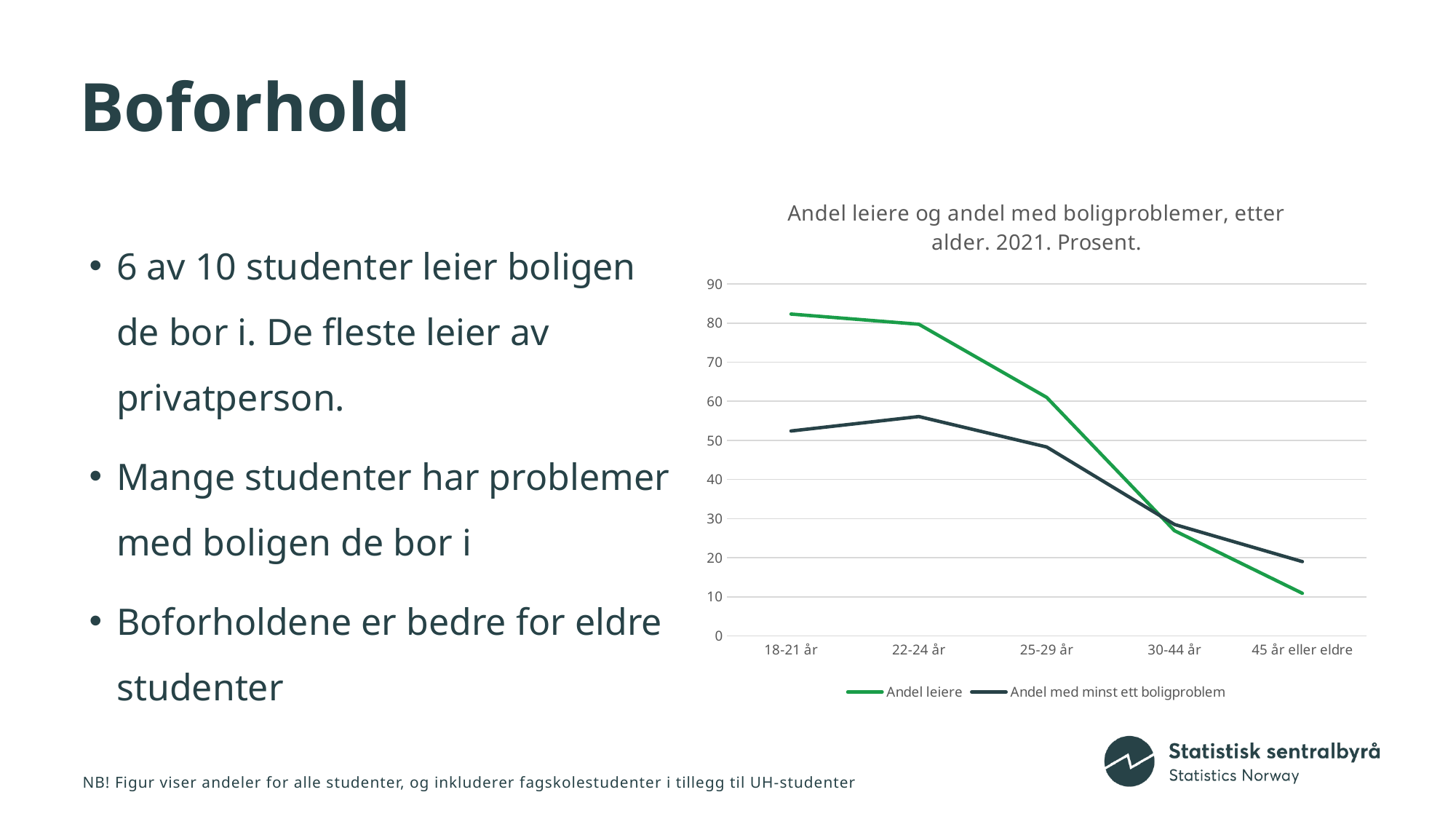
For which age group is 'Andel med minst ett boligproblem' lowest? 45 år eller eldre Does the 'Andel leiere' line rise or fall as age increases along the x axis? Falls For which age group is 'Andel med minst ett boligproblem' highest? 22-24 år At 25-29 år, which series has the higher value, 'Andel leiere' or 'Andel med minst ett boligproblem'? Andel leiere For which age group is 'Andel leiere' lowest? 45 år eller eldre Is the value for 'Andel med minst ett boligproblem' at 30-44 år greater or less than 40? less How many age groups are shown on the x axis of the chart? 5 Is the value for 'Andel leiere' at 45 år eller eldre greater or less than 20? less What is the title of the chart? Andel leiere og andel med boligproblemer, etter alder. 2021. Prosent. What kind of chart is shown on the slide? Line chart Is the value for 'Andel leiere' at 18-21 år greater or less than 70? greater How many series does the chart legend list? 2